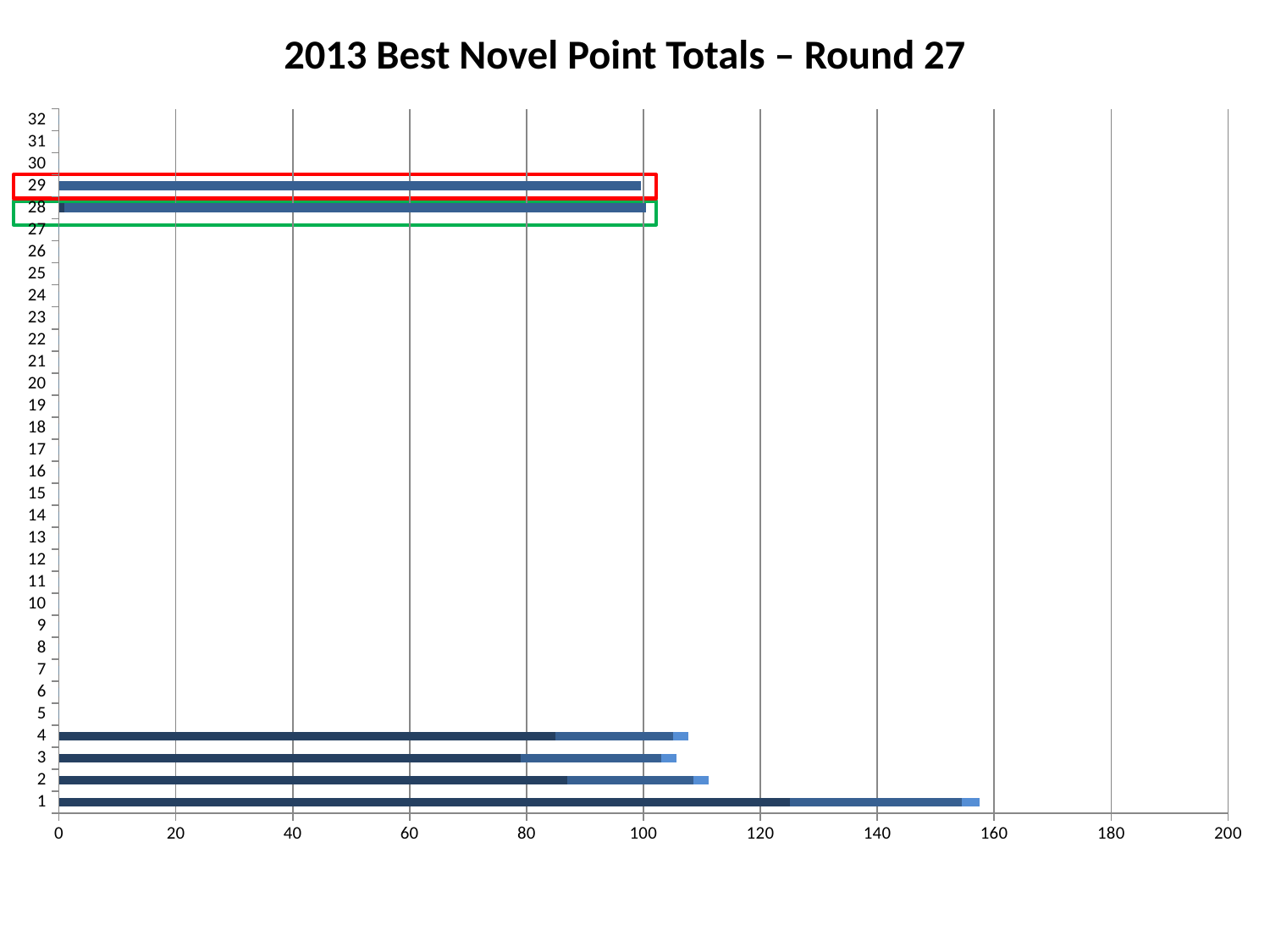
Is the value for category 29 greater or less than 120? less Which has a larger point total, category 1 or category 2? 1 What is the title of the chart? 2013 Best Novel Point Totals – Round 27 Is the value for category 1 greater or less than 140? greater Is the value for category 2 greater or less than 120? less Which category is outlined with a red box? 29 What kind of chart is shown on the slide? bar chart Which has a larger point total, category 29 or category 1? 1 How many categories are listed on the vertical axis? 32 Which category has the highest point total? 1